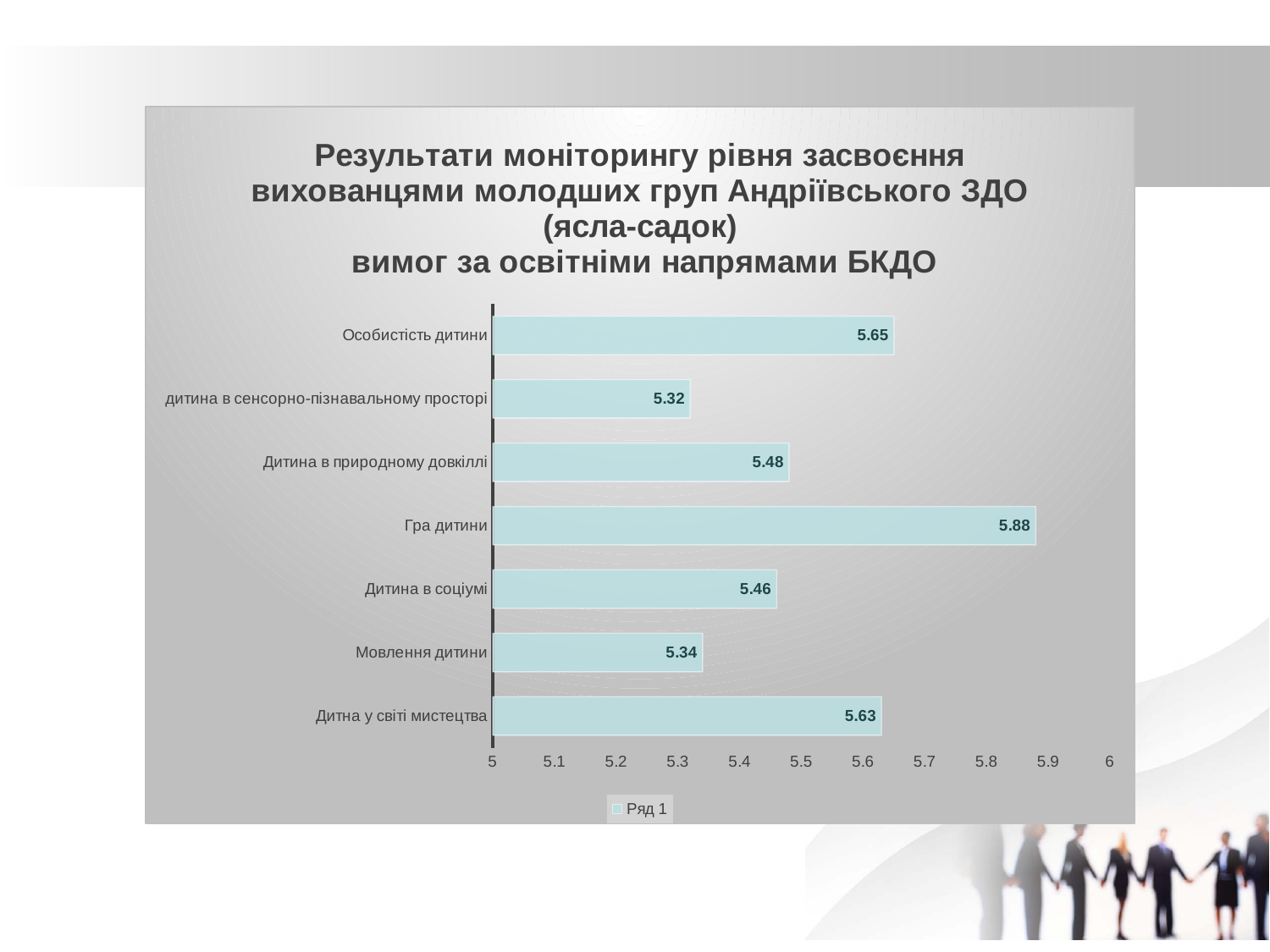
What kind of chart is shown on the slide? bar chart What is the difference between the values for Гра дитини and дитина в сенсорно-пізнавальному просторі? 0.56 How many series does the legend list? 1 What is the name of the series shown in the legend? Ряд 1 What is the value for Мовлення дитини? 5.34 Is the value for Дитина в природному довкіллі greater or less than 5.5? less Which category has the lowest value? дитина в сенсорно-пізнавальному просторі What is the value for Гра дитини? 5.88 How many categories are shown in the chart? 7 What is the value for Дитина в соціумі? 5.46 Which category has the highest value? Гра дитини Which is larger, the value for Особистість дитини or the value for Дитна у світі мистецтва? Особистість дитини